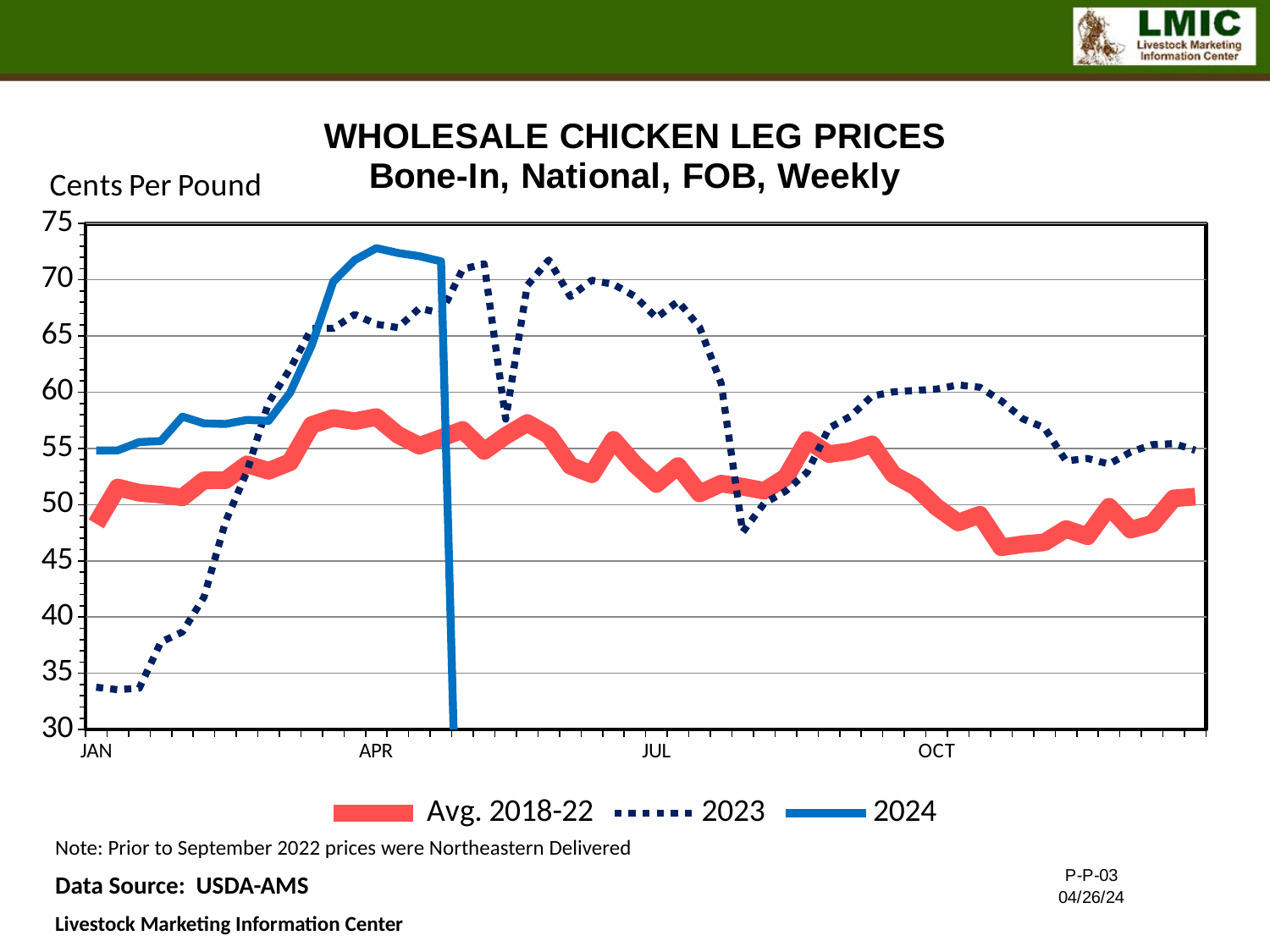
What kind of chart is shown on the slide? Line chart Around April, which series is higher: 2024 or Avg. 2018-22? 2024 What unit is shown on the y axis of the chart? Cents Per Pound Does the 2024 line rise or fall from January to April? Rise Does the Avg. 2018-22 line rise or fall from July to October? Fall Is the value for 2023 at the start of January greater or less than 35? less How many series does the legend list? 3 Is the value for Avg. 2018-22 at the start of January greater or less than 50? less At the start of January, which series is higher: 2023 or 2024? 2024 What is the title of the chart? WHOLESALE CHICKEN LEG PRICES Bone-In, National, FOB, Weekly Is the value for 2024 at the start of January greater or less than 50? greater